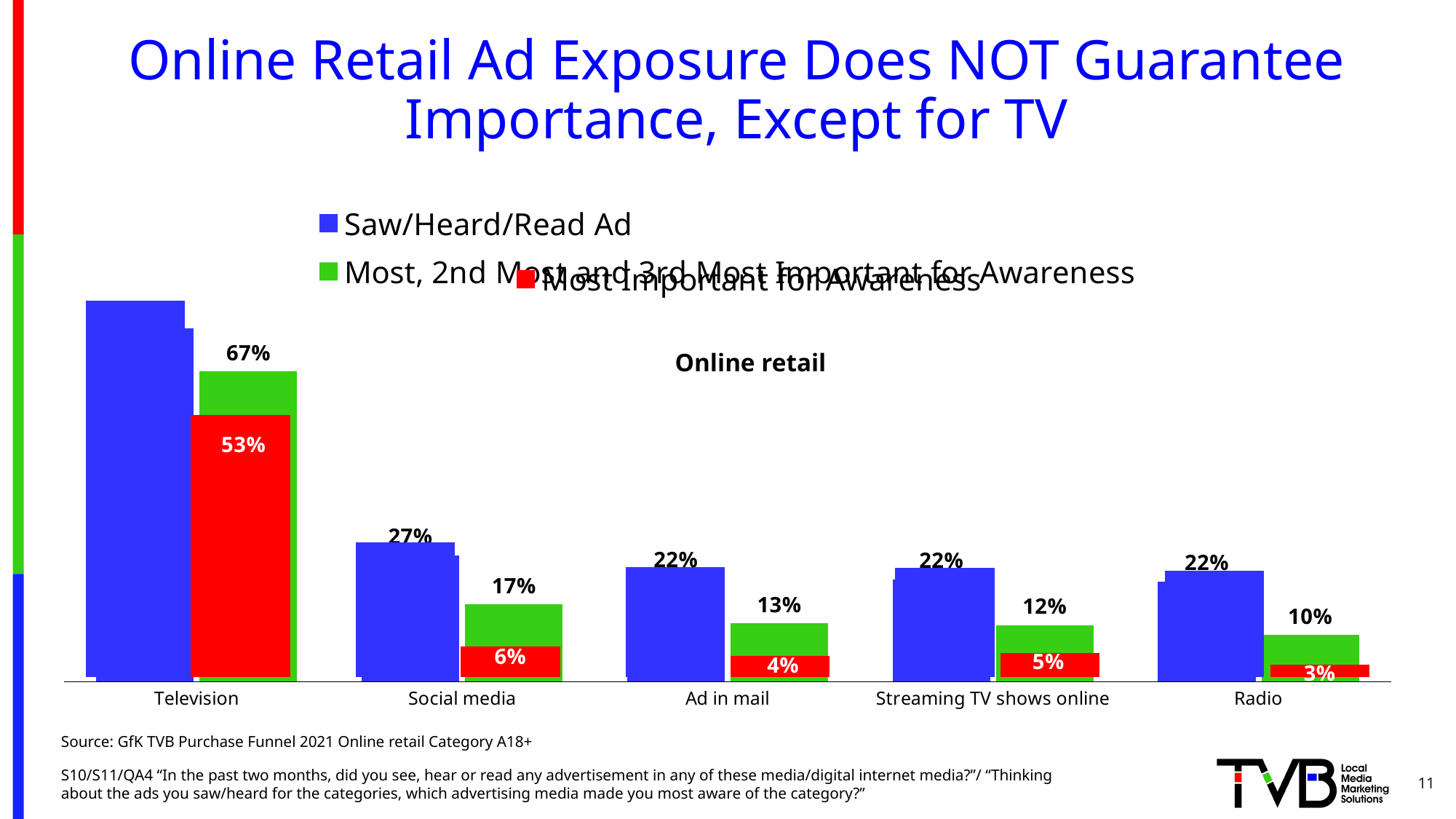
What type of chart is shown on the slide? Bar chart What is the Most, 2nd Most and 3rd Most Important for Awareness value for Streaming TV shows online? 12% Which category has the highest Saw/Heard/Read Ad value? Television How many series does the legend list? 3 How many media categories are shown on the x axis? 5 What is the Saw/Heard/Read Ad value for Social media? 27% Which category has the lowest Most Important for Awareness value? Radio What is the value for Television in the Most, 2nd Most and 3rd Most Important for Awareness series? 67% What is the Most Important for Awareness value for Radio? 3% What is the value for Television in the Most Important for Awareness series? 53% Which is larger: the Most Important for Awareness value for Ad in mail or for Streaming TV shows online? Streaming TV shows online What is the difference between the Most, 2nd Most and 3rd Most Important for Awareness value and the Most Important for Awareness value for Social media? 11%